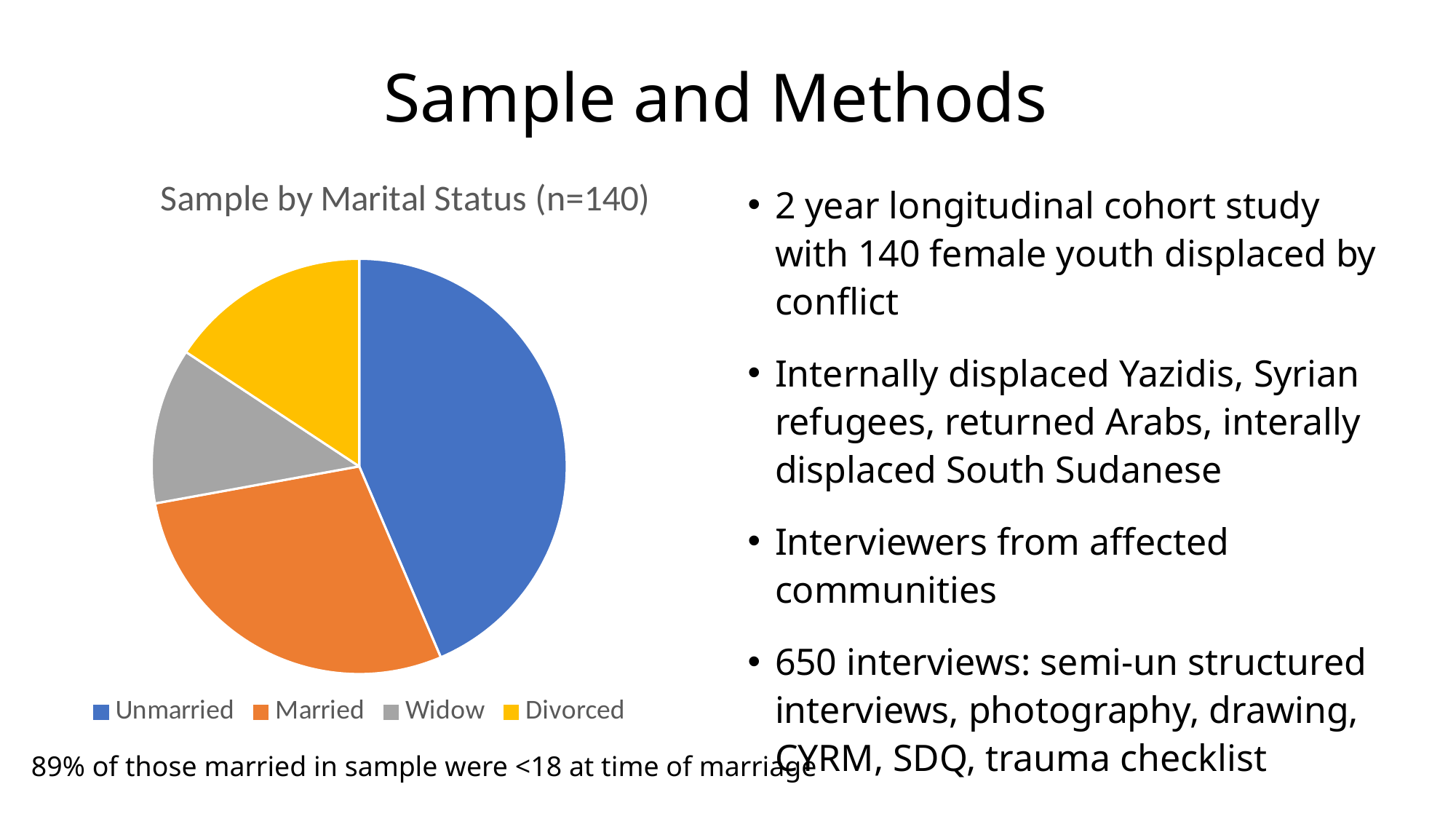
What is the sample size (n) stated in the chart title? 140 How many entries does the chart legend list? 4 Which marital status category has the largest share of the pie? Unmarried Which is larger in the pie chart, the Unmarried slice or the Married slice? Unmarried Which is larger in the pie chart, the Married slice or the Widow slice? Married Which is larger in the pie chart, the Unmarried slice or the Divorced slice? Unmarried How many categories does the pie chart show? 4 What colour represents the Married category in the pie chart? orange What is the title of the chart? Sample by Marital Status (n=140) What kind of chart is shown on the slide? pie chart